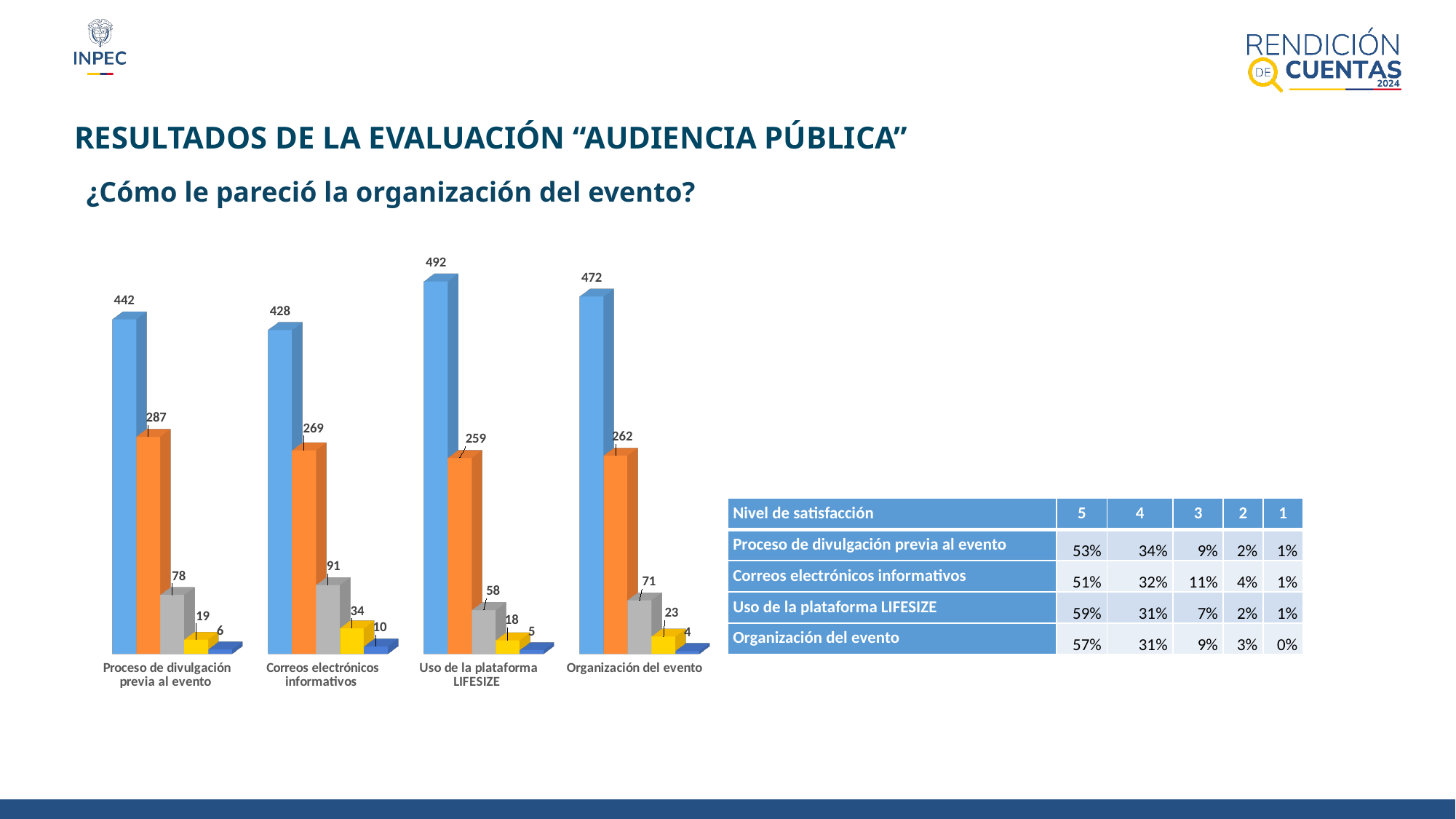
What is the difference between the blue bars for "Uso de la plataforma LIFESIZE" and "Organización del evento"? 20 Which category has the lowest blue bar? Correos electrónicos informativos Which category has the highest blue bar? Uso de la plataforma LIFESIZE What is the value of the blue bar for "Uso de la plataforma LIFESIZE"? 492 What is the value of the yellow bar for "Organización del evento"? 23 What is the value of the gray bar for "Correos electrónicos informativos"? 91 Which is larger: the orange bar for "Proceso de divulgación previa al evento" or the orange bar for "Correos electrónicos informativos"? Proceso de divulgación previa al evento What is the value of the orange bar for "Proceso de divulgación previa al evento"? 287 How many bars are shown for each category in the chart? 5 What kind of chart is shown on the slide? Bar chart How many categories are shown on the x axis of the chart? 4 What is the value of the smallest bar for "Uso de la plataforma LIFESIZE"? 5